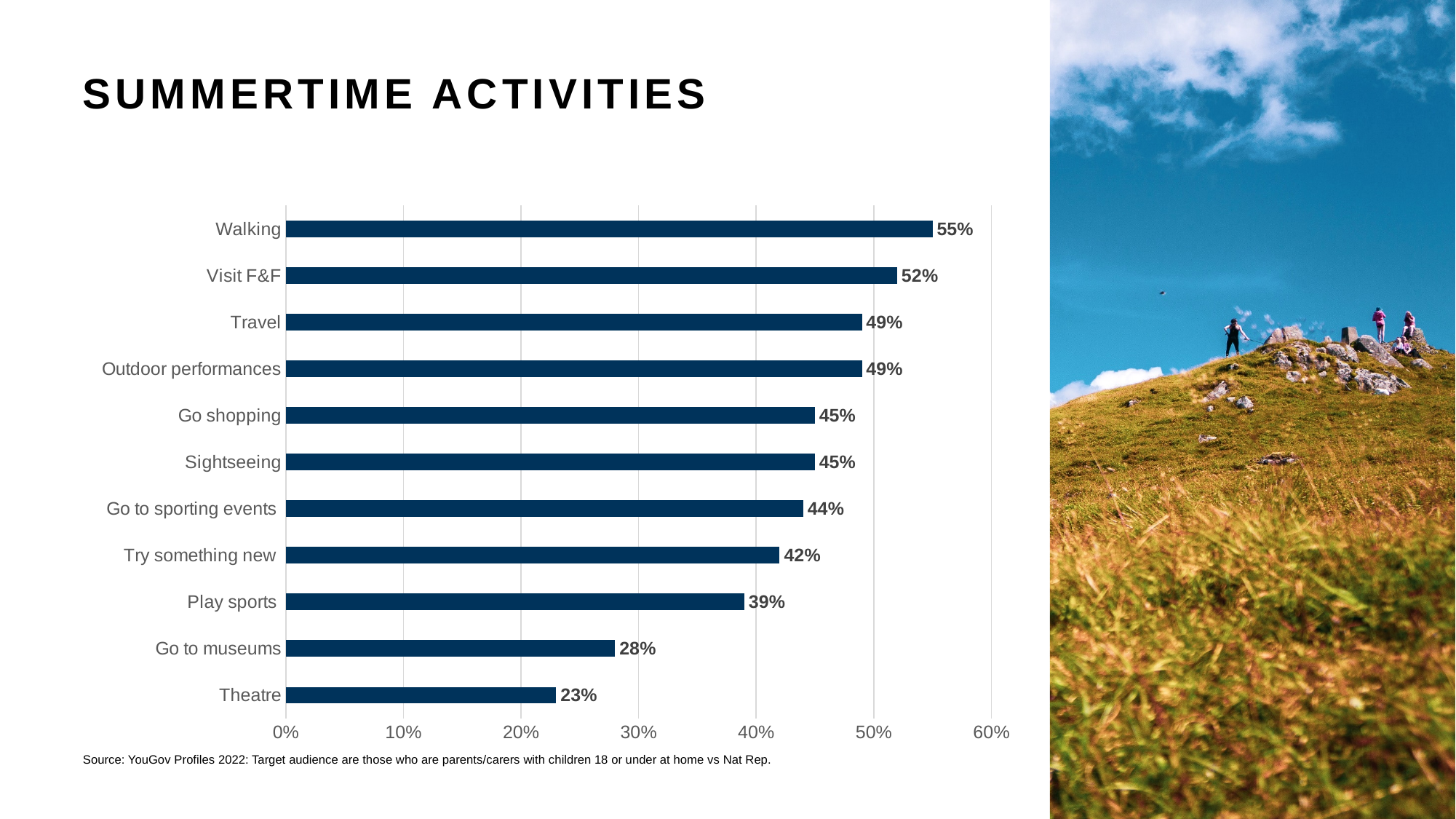
What is the difference between the values for Walking and Theatre? 32% What kind of chart is shown on the slide? Bar chart Which activity has the lowest value? Theatre How many activities are shown in the chart? 11 What is the difference between the values for Visit F&F and Play sports? 13% What percentage is shown for Try something new? 42% What is the value for Go to museums? 28% What is the title of the slide? SUMMERTIME ACTIVITIES Which is larger, the value for Go shopping or the value for Play sports? Go shopping Which activity has the highest value? Walking Is the value for Go to sporting events greater or less than 40%? greater What percentage is shown for Walking? 55%